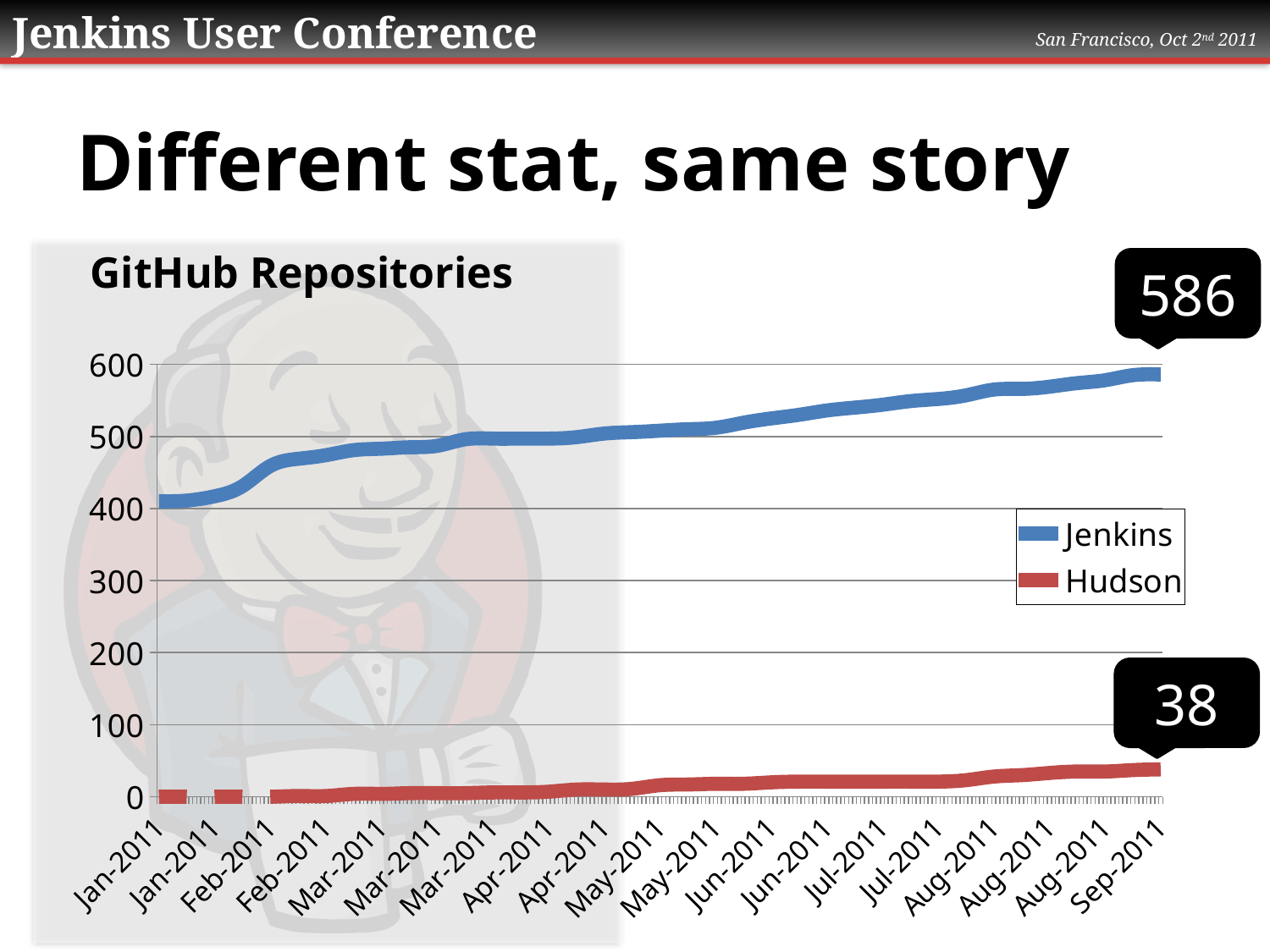
What kind of chart is shown on the slide? line chart What is the final value shown for Hudson in the GitHub Repositories chart? 38 Is the value for Hudson in Sep-2011 greater or less than 100? less How many series does the legend of the GitHub Repositories chart list? 2 Is the value for Jenkins in Jul-2011 greater or less than 500? greater What is the difference between the final Jenkins value and the final Hudson value? 548 What is the final value shown for Jenkins in the GitHub Repositories chart? 586 What is the title of the chart? GitHub Repositories Does the Jenkins line rise or fall from Jan-2011 to Sep-2011? rise Which series has the lowest values throughout the chart? Hudson Which series has the higher final value, Jenkins or Hudson? Jenkins What colour is the Hudson line in the chart? red